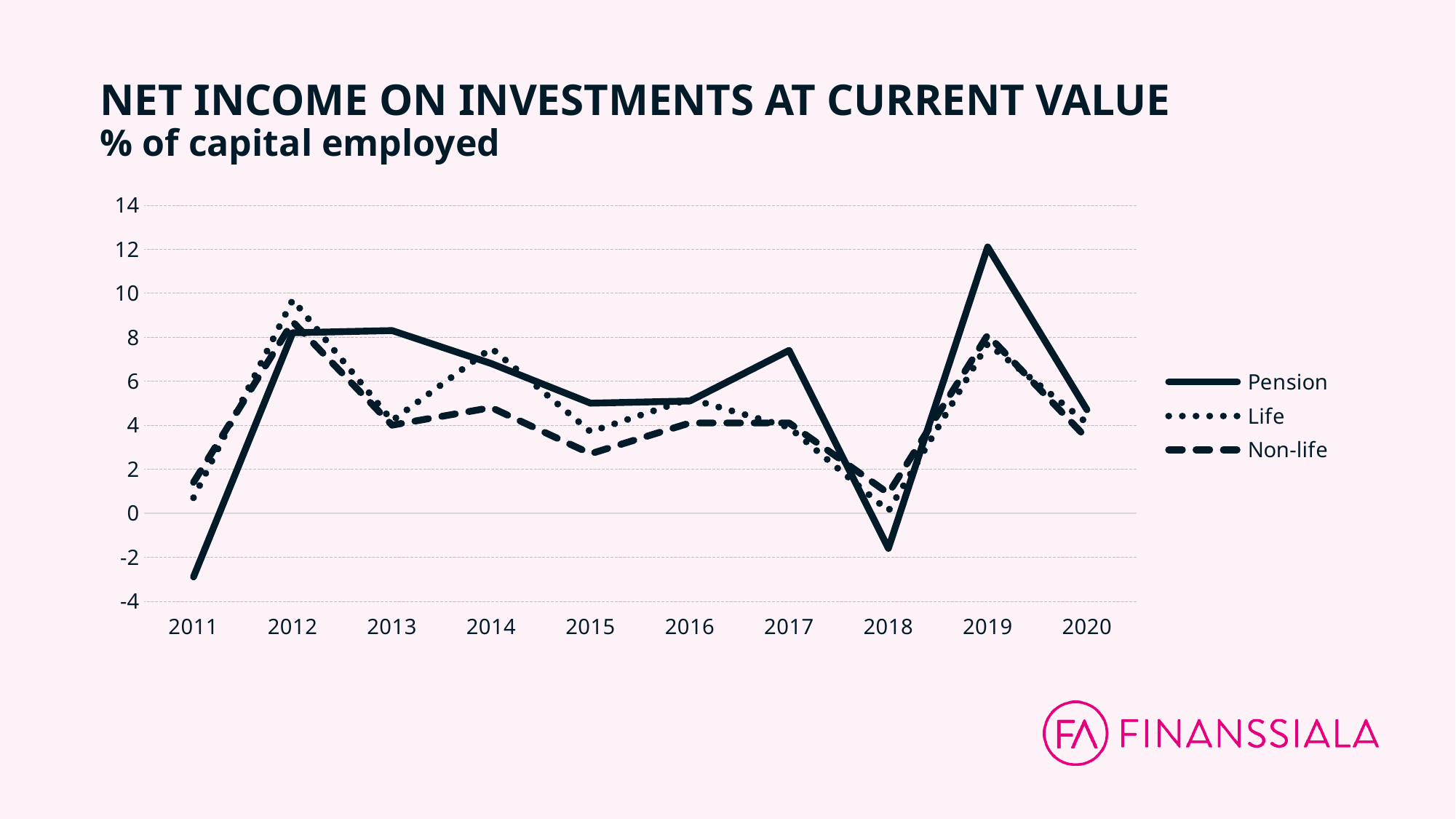
Is the value for Life in 2012 greater or less than 8? greater How many years are shown on the x axis? 10 In which year does the Pension series reach its highest value? 2019 Is the value for Pension in 2011 greater or less than 0? less What is the subtitle of the chart, shown below the main title? % of capital employed How many series does the legend list? 3 In which year does the Pension series reach its lowest value? 2011 Is the value for Pension in 2019 greater or less than 10? greater What kind of chart is shown on the slide? line chart Does the Pension series rise or fall from 2019 to 2020? fall Which series has the higher value in 2017, Pension or Non-life? Pension